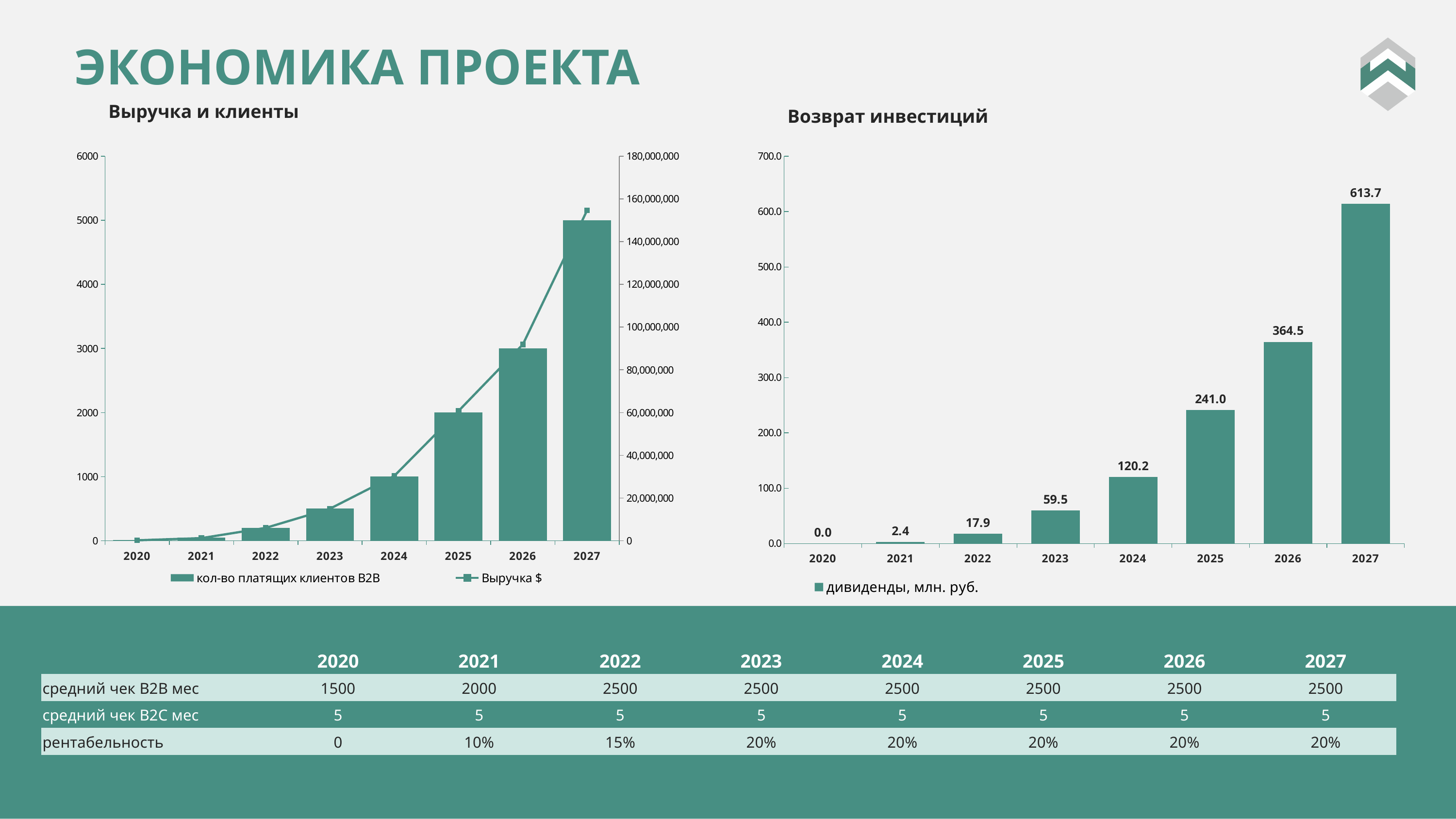
In the 'Выручка и клиенты' chart, what is the number of paying B2B clients for 2027? 5000 In the 'Выручка и клиенты' chart, is the number of paying B2B clients for 2025 greater or less than 1000? greater In the 'Возврат инвестиций' chart, which is larger: the value for 2023 or the value for 2022? 2023 In the 'Возврат инвестиций' chart, what is the value for 2024? 120.2 In the 'Возврат инвестиций' chart, which year has the highest value? 2027 In the 'Возврат инвестиций' chart, what is the value for 2027? 613.7 In the 'Возврат инвестиций' chart, do the values rise or fall from 2020 to 2027? rise How many years are shown on the x axis of the 'Возврат инвестиций' chart? 8 What is the legend entry for the bar series in the 'Возврат инвестиций' chart? дивиденды, млн. руб. How many series does the legend of the 'Выручка и клиенты' chart list? 2 In the 'Возврат инвестиций' chart, what is the difference between the values for 2027 and 2026? 249.2 What kind of chart is the 'Возврат инвестиций' chart? bar chart